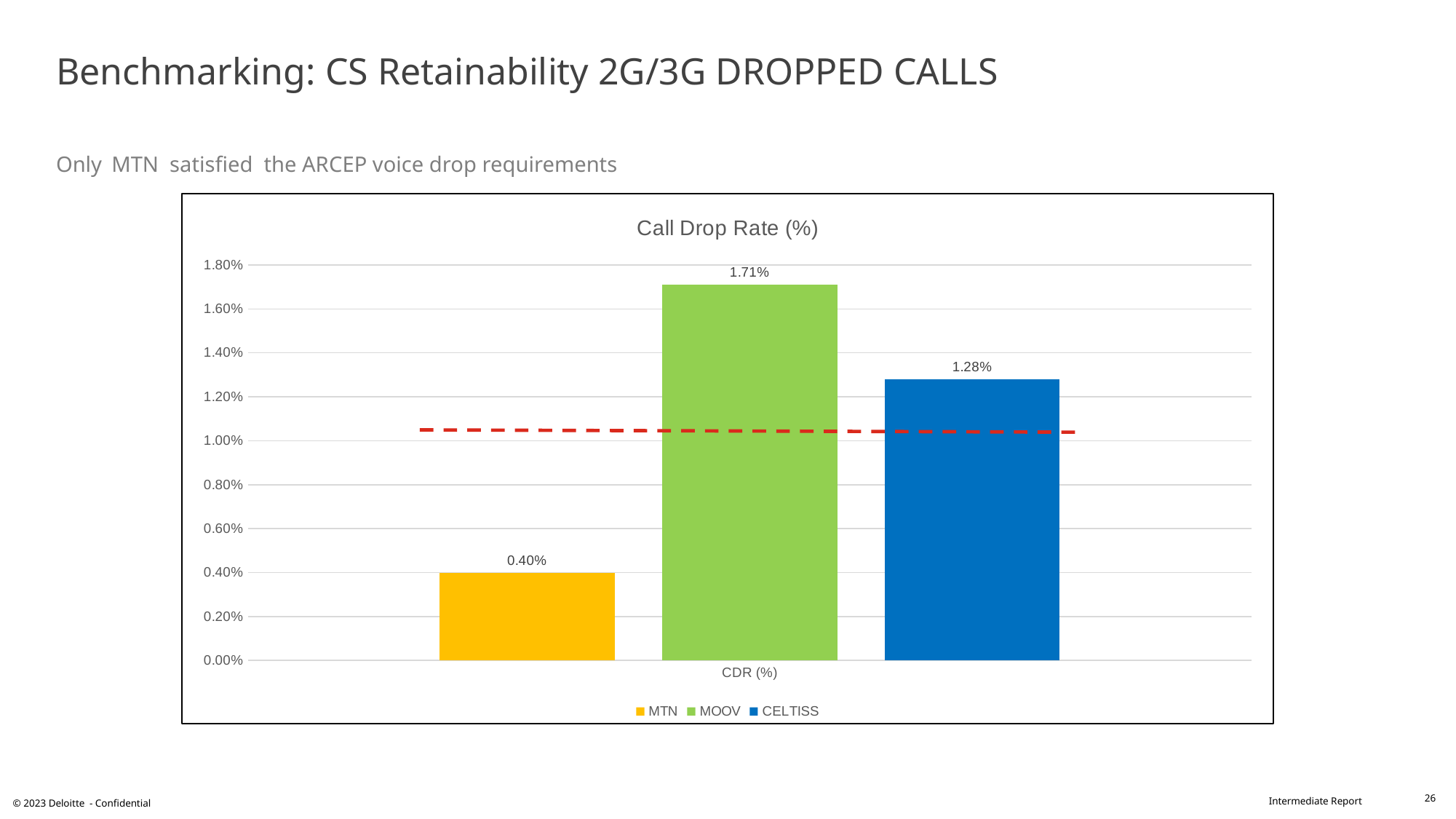
Is the Call Drop Rate for CELTISS greater or less than 1.00%? greater What is the Call Drop Rate for MTN? 0.40% How many series does the legend list? 3 What is the Call Drop Rate for CELTISS? 1.28% What kind of chart is shown on the slide? Bar chart What is the difference between the Call Drop Rate of CELTISS and MTN? 0.88% What is the title of the chart? Call Drop Rate (%) Which has a higher Call Drop Rate, CELTISS or MTN? CELTISS What is the Call Drop Rate for MOOV? 1.71% What is the difference between the Call Drop Rate of MOOV and CELTISS? 0.43% Which operator has the lowest Call Drop Rate? MTN Which operator has the highest Call Drop Rate? MOOV